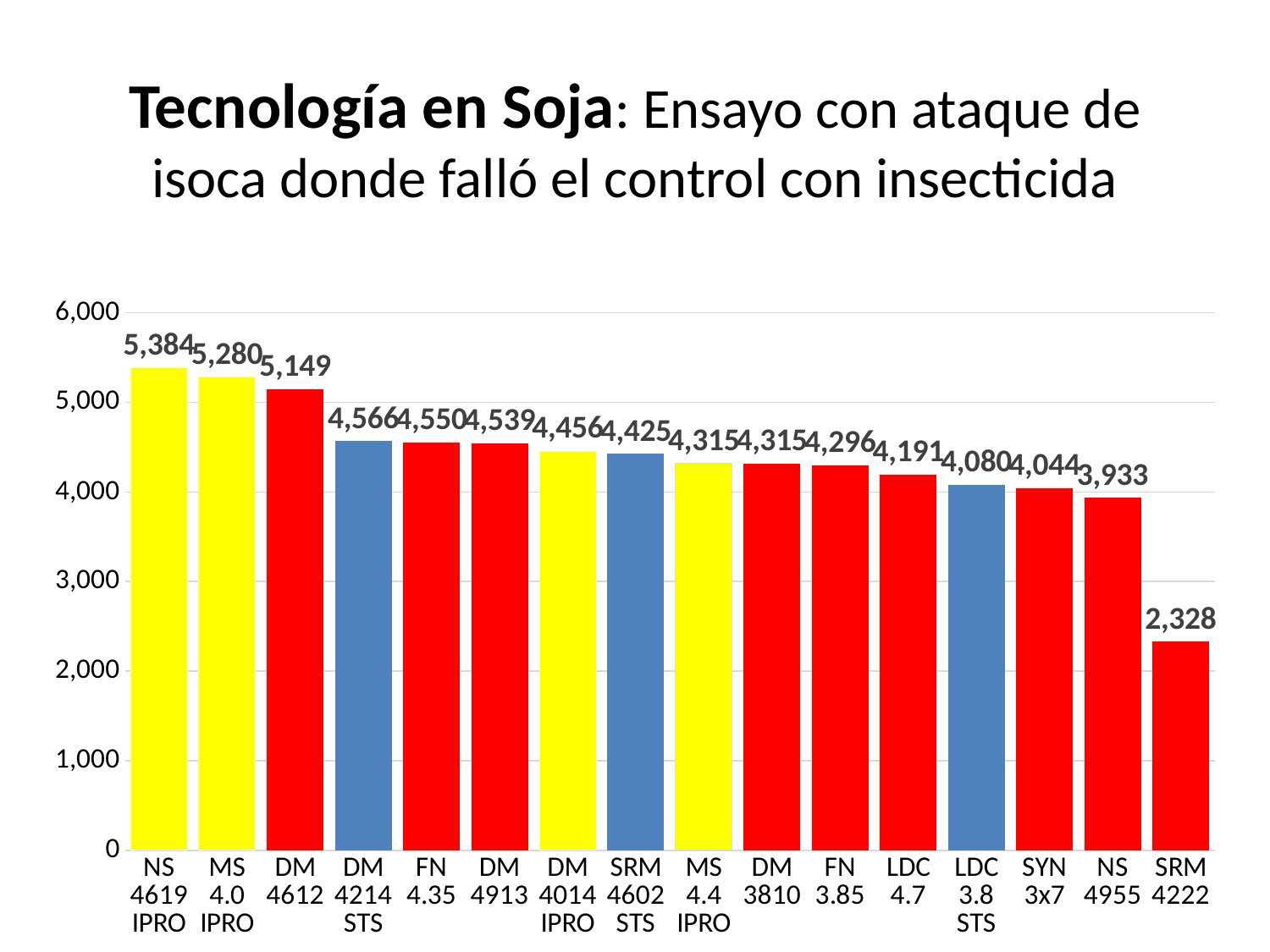
Which is larger, the value for DM 4214 STS or the value for SYN 3x7? DM 4214 STS What is the value for DM 4913? 4,539 What is the value for LDC 3.8 STS? 4,080 What is the value for SRM 4222? 2,328 What is the difference between the values for MS 4.0 IPRO and DM 4612? 131 What is the difference between the values for NS 4619 IPRO and SRM 4222? 3,056 Which category has the highest value? NS 4619 IPRO How many categories are shown in the chart? 16 What kind of chart is shown on the slide? Bar chart Is the value for NS 4955 greater or less than 3,000? greater Which category has the lowest value? SRM 4222 What is the value for NS 4619 IPRO? 5,384